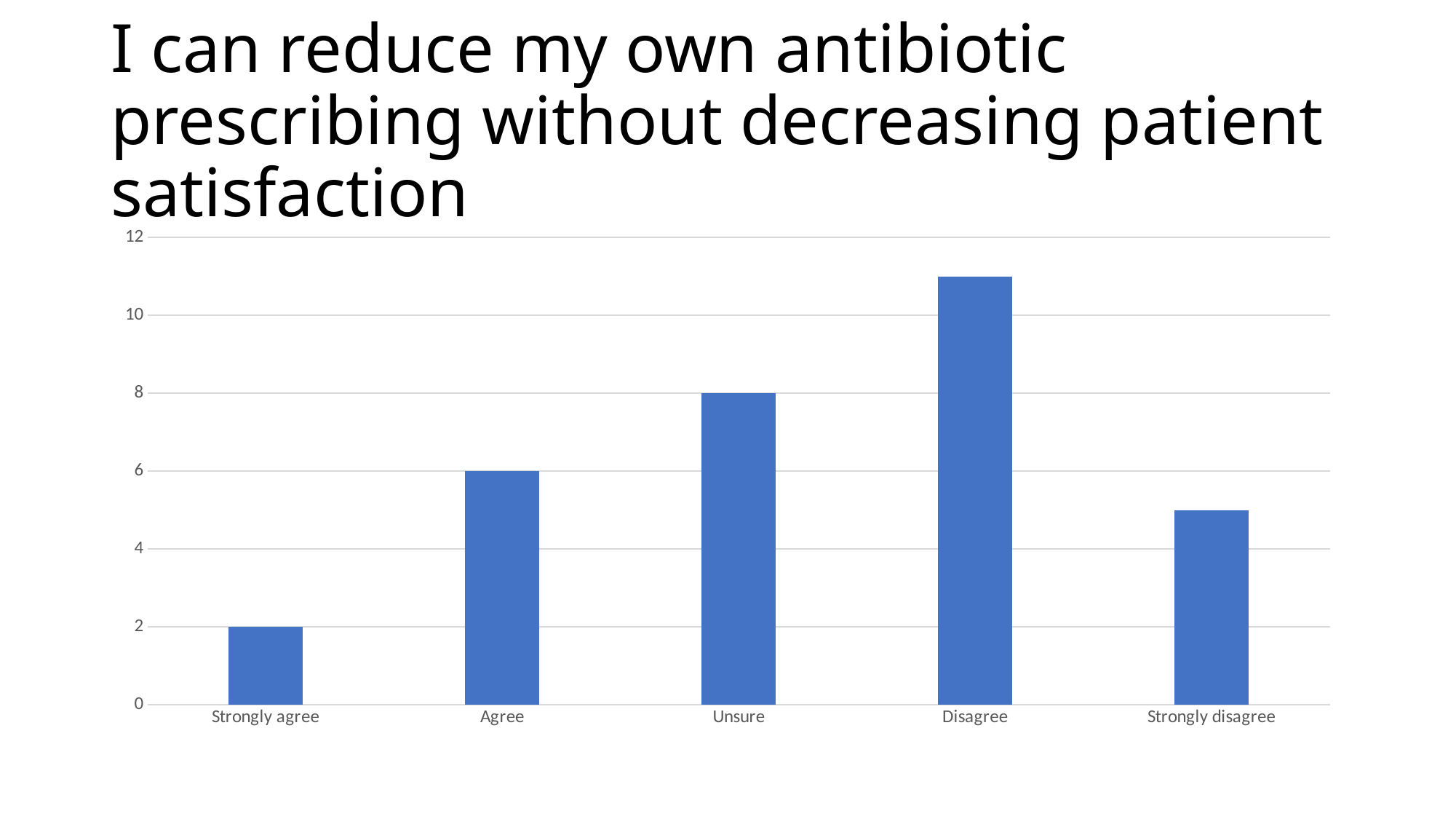
Which category has the lowest value? Strongly agree What kind of chart is shown on the slide? bar chart Which category has the highest value? Disagree Is the value for Strongly disagree greater or less than 6? less Which is larger, the value for Disagree or the value for Strongly disagree? Disagree What is the value for Strongly agree? 2 What is the difference between the values for Unsure and Agree? 2 How many categories are shown on the x axis? 5 What is the difference between the values for Agree and Strongly agree? 4 What is the value for Agree? 6 Is the value for Disagree greater or less than 10? greater What is the value for Unsure? 8